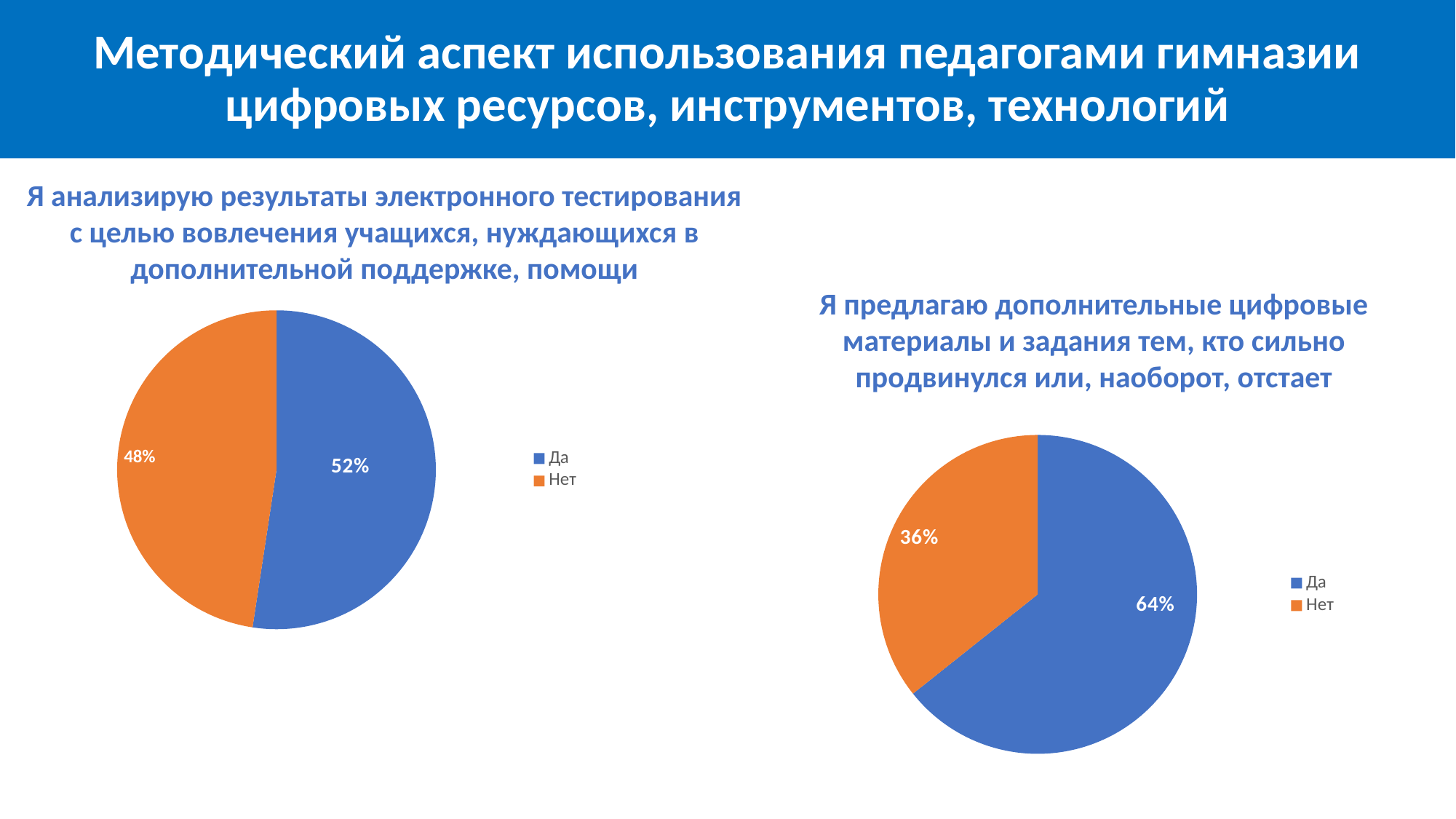
In the left pie chart ("Я анализирую результаты электронного тестирования..."), what share of respondents answered "Да"? 52% Is the "Да" share larger in the left pie chart or in the right pie chart? Right pie chart In the right pie chart ("Я предлагаю дополнительные цифровые материалы..."), what is the difference in percentage points between the "Да" and "Нет" slices? 28 In the right pie chart ("Я предлагаю дополнительные цифровые материалы..."), what share of respondents answered "Нет"? 36% What type of chart is used on the left side of the slide? Pie chart In the right pie chart ("Я предлагаю дополнительные цифровые материалы..."), what share of respondents answered "Да"? 64% In the left pie chart ("Я анализирую результаты электронного тестирования..."), what share of respondents answered "Нет"? 48% In the left pie chart ("Я анализирую результаты электронного тестирования..."), which colour represents "Нет"? Orange In the left pie chart ("Я анализирую результаты электронного тестирования..."), which answer has the smallest slice? Нет How many slices does the right pie chart ("Я предлагаю дополнительные цифровые материалы...") have? 2 In the left pie chart ("Я анализирую результаты электронного тестирования..."), what is the difference in percentage points between the "Да" and "Нет" slices? 4 In the right pie chart ("Я предлагаю дополнительные цифровые материалы..."), which answer has the largest slice? Да